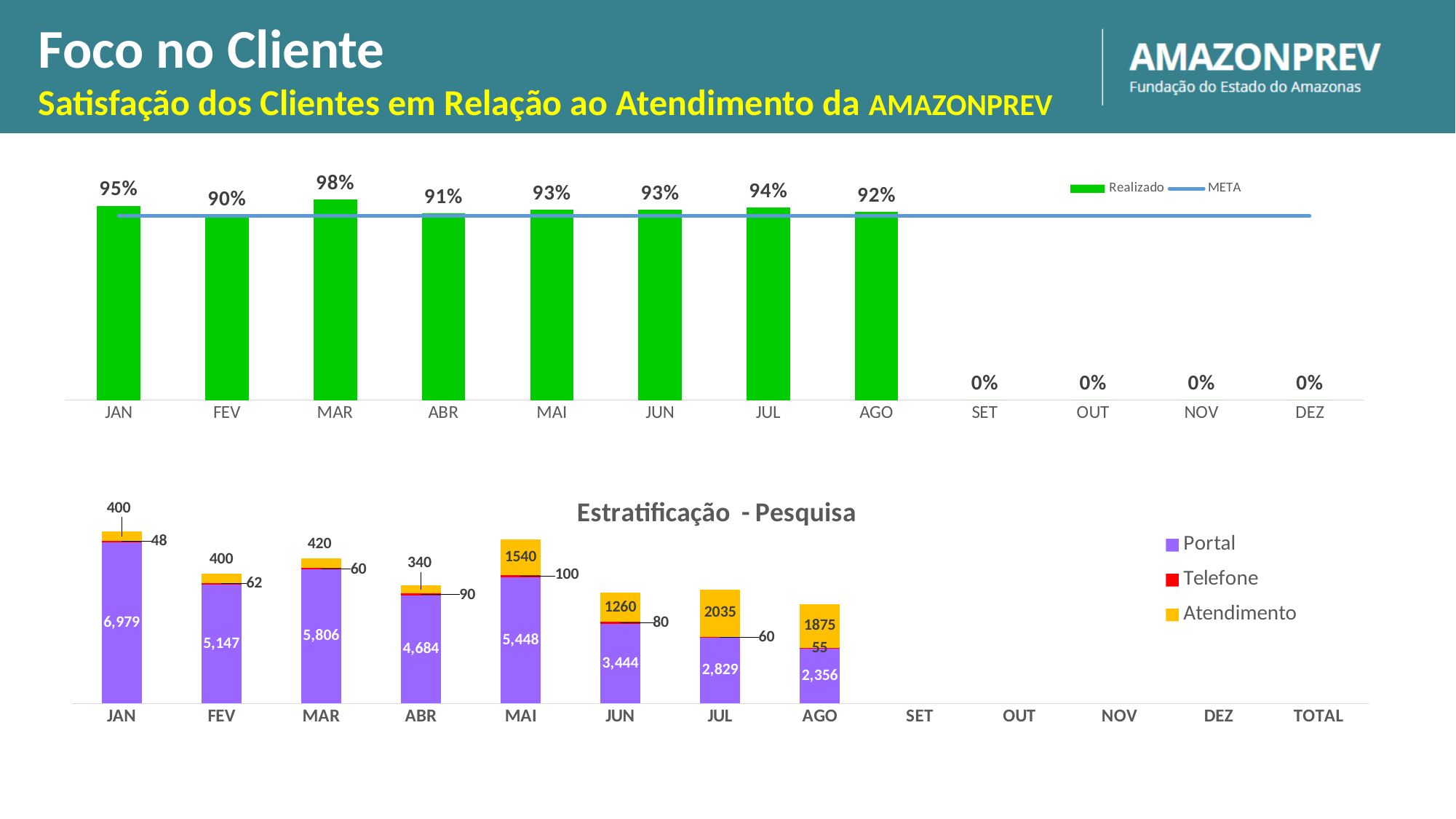
In the bottom chart (Estratificação - Pesquisa), what is the total of the stacked bar for JAN? 7,427 In the top chart, what is the Realizado value for MAR? 98% In the bottom chart (Estratificação - Pesquisa), which is larger, the Telefone value for MAI or for JAN? MAI In the bottom chart (Estratificação - Pesquisa), what is the Portal value for JAN? 6,979 In the top chart, among the months JAN to AGO, which has the lowest Realizado value? FEV In the top chart, how many series does the legend list? 2 In the bottom chart (Estratificação - Pesquisa), which month has the highest Atendimento value? JUL In the bottom chart (Estratificação - Pesquisa), what is the Atendimento value for JUL? 2035 In the top chart, what is the difference between the Realizado values for MAR and FEV? 8 percentage points In the bottom chart (Estratificação - Pesquisa), how many series does the legend list? 3 What kind of chart is the top chart? Bar chart with a line In the top chart, which month has the highest Realizado value? MAR